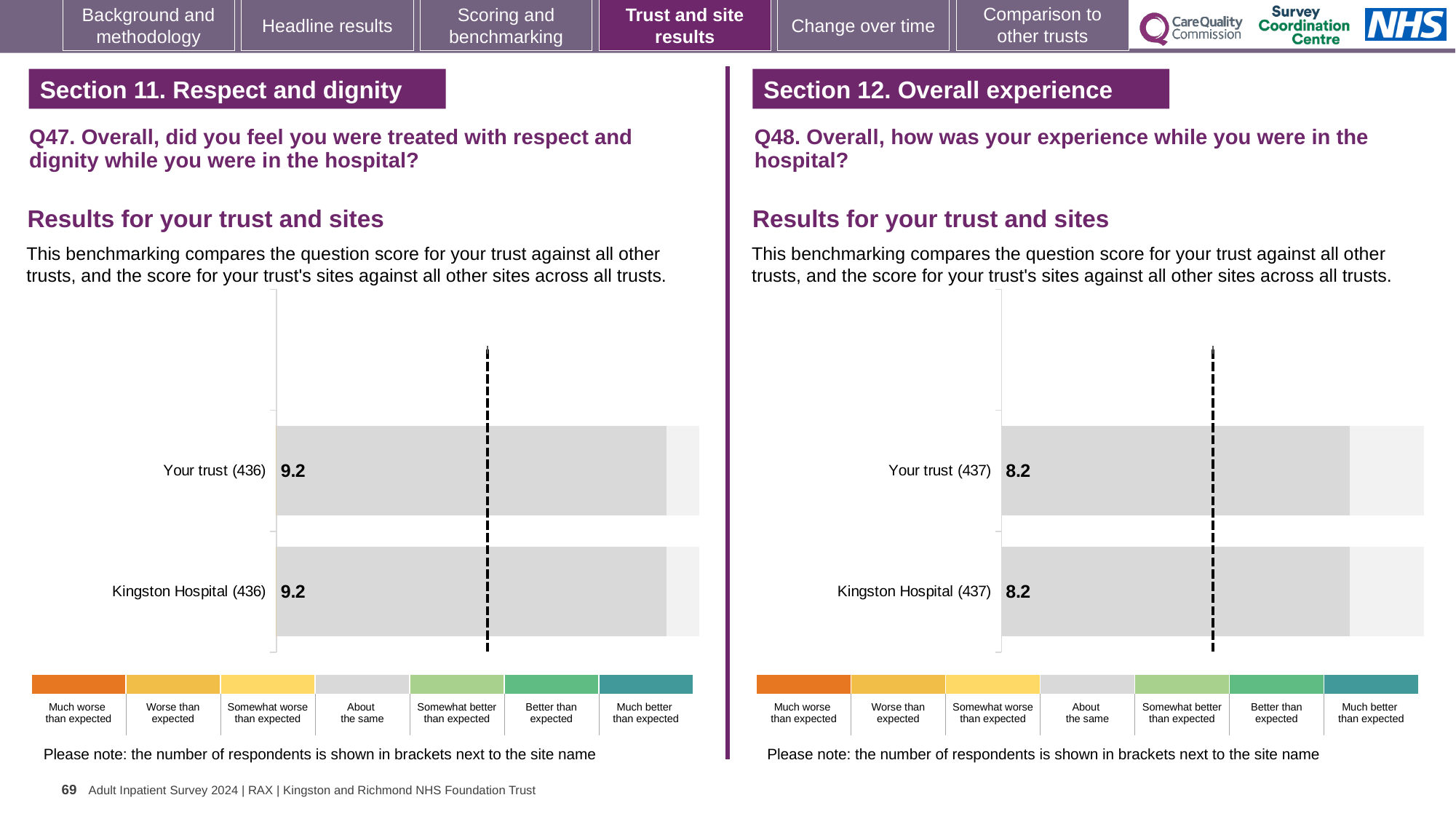
How many bars are plotted in the Q48 chart on the right? 2 How many bars are plotted in the Q47 chart on the left? 2 In the Q48 chart on the right, how many respondents are shown in brackets next to Kingston Hospital? 437 What kind of chart is used for the Q48 results on the right? Bar chart In the Q47 chart on the left, what is the score for Your trust? 9.2 In the Q48 chart on the right, what is the score for Your trust? 8.2 Is the score for Your trust in the Q47 chart on the left larger than the score for Your trust in the Q48 chart on the right? Yes In the Q47 chart on the left, what is the score for Kingston Hospital? 9.2 In the Q48 chart on the right, what is the score for Kingston Hospital? 8.2 In the Q47 chart on the left, what is the difference between the score for Your trust and the score for Kingston Hospital? 0 In the Q48 chart on the right, what is the difference between the score for Your trust and the score for Kingston Hospital? 0 In the Q47 chart on the left, how many respondents are shown in brackets next to Your trust? 436